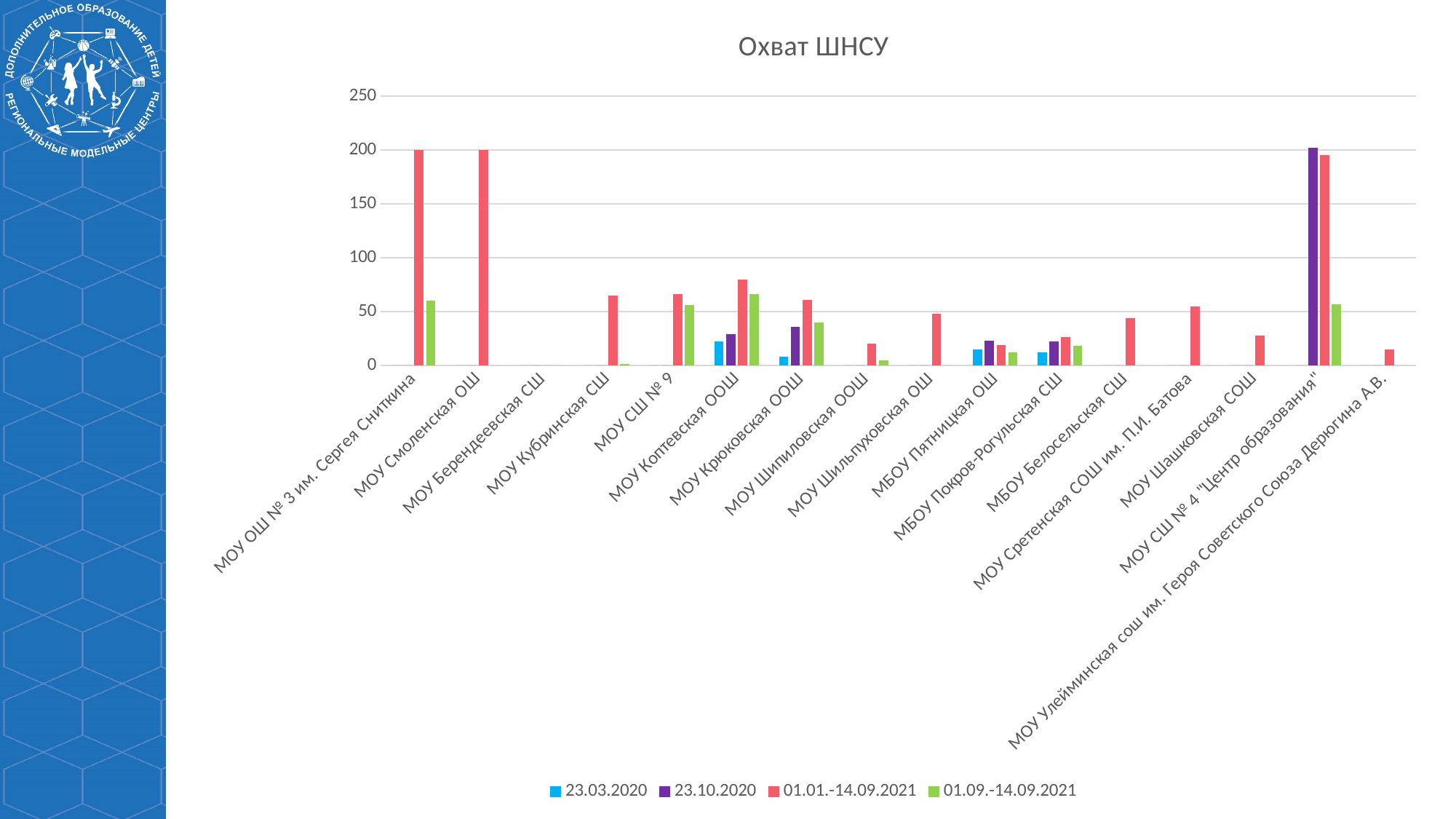
For МОУ Коптевская ООШ, which series has the larger value: 23.03.2020 or 01.01.-14.09.2021? 01.01.-14.09.2021 What is the title of the chart? Охват ШНСУ How many series does the legend list? 4 Which has the larger 01.01.-14.09.2021 value: МОУ Смоленская ОШ or МОУ Шипиловская ООШ? МОУ Смоленская ОШ Is the 01.01.-14.09.2021 value for МОУ Кубринская СШ greater or less than 100? less What kind of chart is shown on the slide? bar chart Is the 01.09.-14.09.2021 value for МОУ ОШ № 3 им. Сергея Сниткина greater or less than 50? greater Is the 01.01.-14.09.2021 value for МОУ Шашковская СОШ greater or less than 50? less How many schools (categories) are shown on the x axis? 16 Which school has the highest value for the 23.10.2020 series? МОУ СШ № 4 "Центр образования" Which legend entry is shown in green? 01.09.-14.09.2021